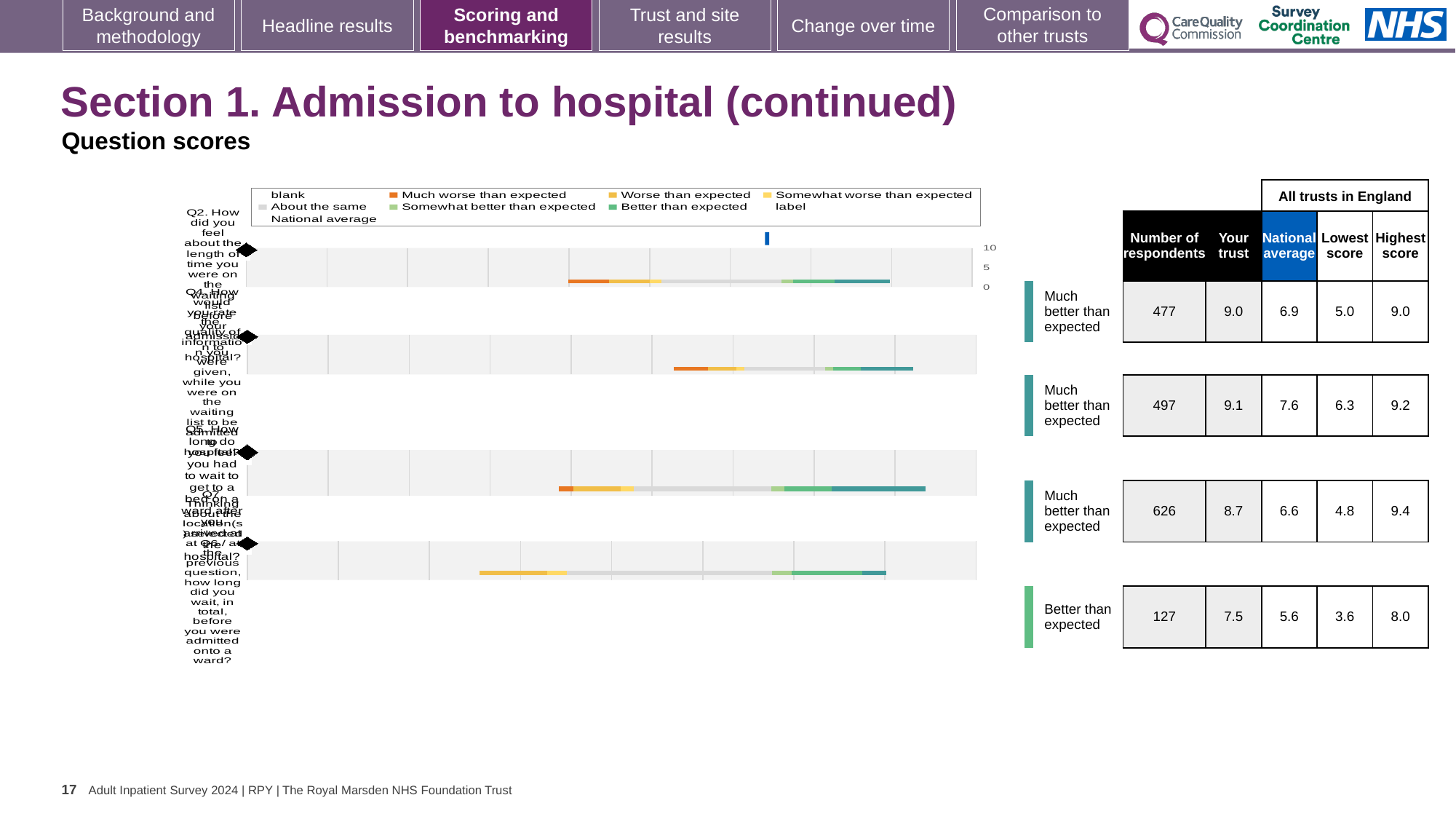
What is the national average for the row with 626 respondents? 6.6 What is the difference between 'Your trust' and the national average for the row with 477 respondents? 2.1 What is the 'Your trust' score for the row with 497 respondents? 9.1 How many respondents are shown for the first question row (Q2) in the table? 477 For the row with 127 respondents, which is larger: the trust score or the national average? Your trust (7.5) What heading spans the National average, Lowest score and Highest score columns? All trusts in England Which row has the highest 'Your trust' score? The row with 497 respondents (9.1) How many question rows are plotted on the chart? 4 What is the lowest 'Your trust' score shown in the table? 7.5 What benchmark category is given for the row with 127 respondents? Better than expected What is the highest score in England for the row with 497 respondents? 9.2 What is the lowest score in England for the row with 626 respondents? 4.8